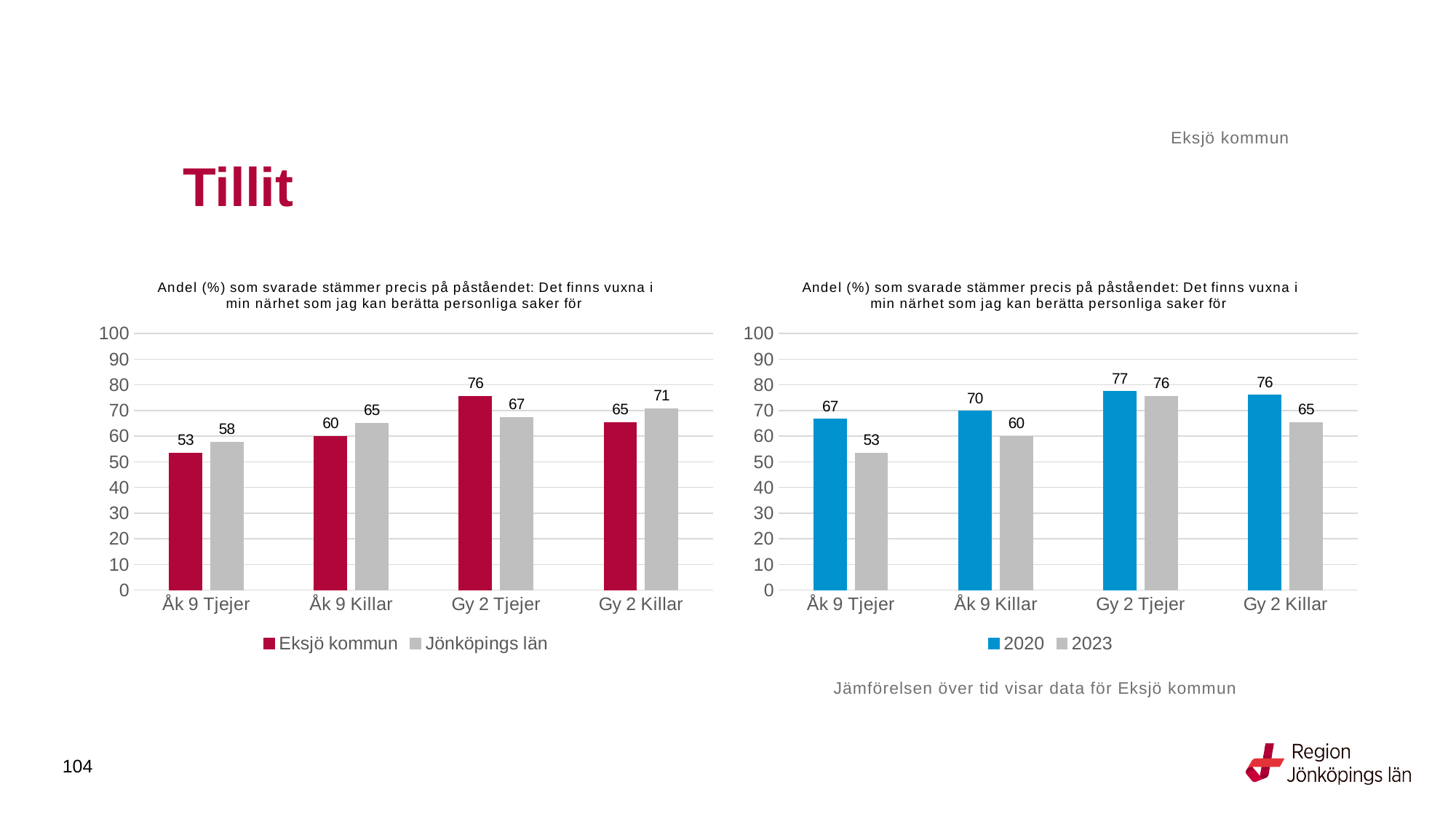
In the left chart, which is larger for Gy 2 Tjejer: Eksjö kommun or Jönköpings län? Eksjö kommun How many series does the legend of the right chart list? 2 In the left chart, which category has the lowest value for Jönköpings län? Åk 9 Tjejer In the right chart, what is the value for 2020 for Gy 2 Tjejer? 77 In the right chart, what is the value for 2023 for Åk 9 Killar? 60 In the right chart, what is the difference between 2020 and 2023 for Åk 9 Tjejer? 14 In the left chart, what is the difference between Jönköpings län and Eksjö kommun for Gy 2 Killar? 6 In the right chart, which category has the lowest value for 2023? Åk 9 Tjejer What kind of chart is the left chart? Bar chart In the left chart, what is the value for Jönköpings län for Gy 2 Killar? 71 In the left chart, what is the value for Eksjö kommun for Åk 9 Tjejer? 53 In the left chart, which category has the highest value for Eksjö kommun? Gy 2 Tjejer